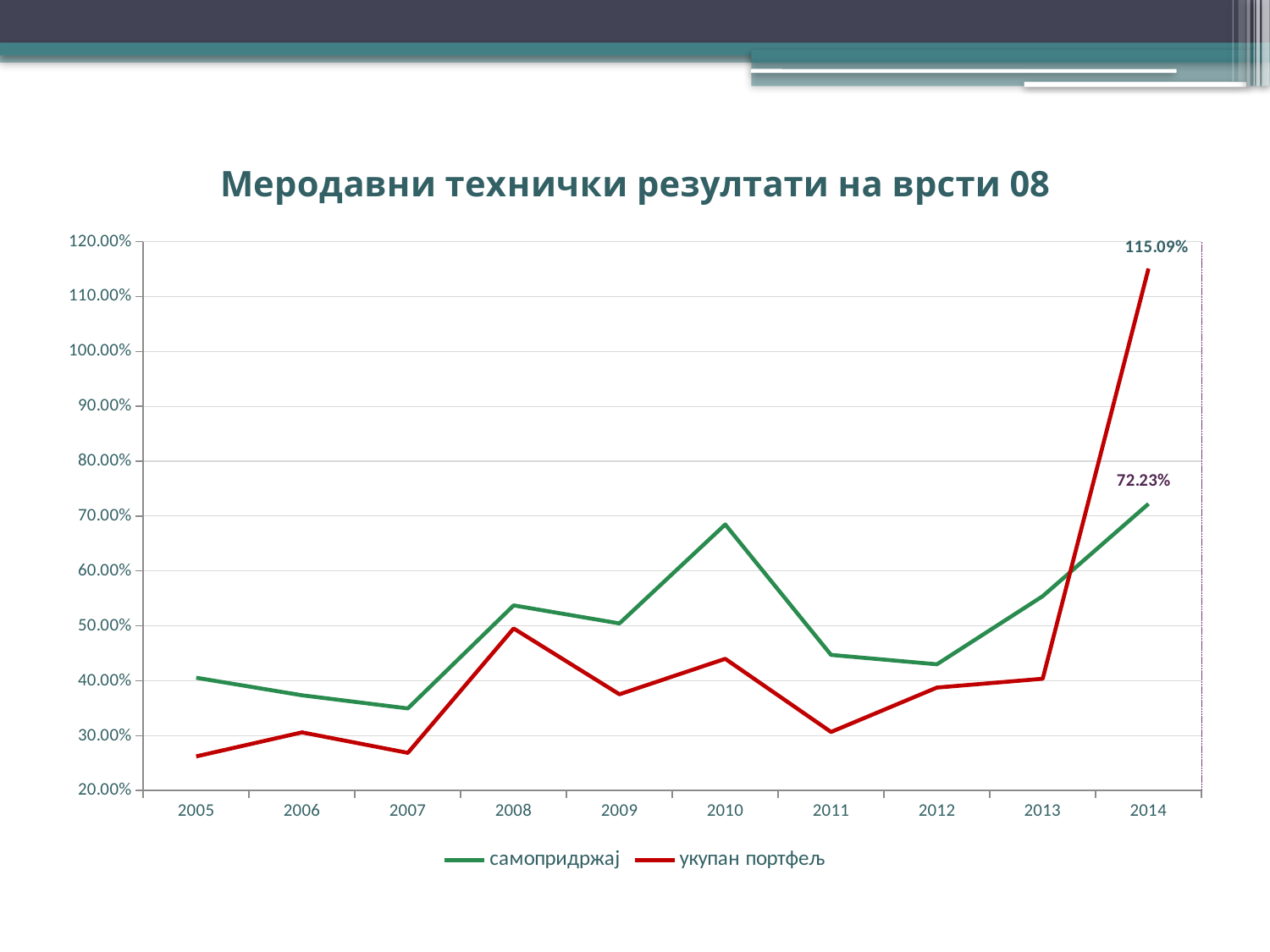
What is the value for укупан портфељ in 2014? 115.09% What kind of chart is shown on the slide? line chart Is the value for укупан портфељ in 2005 greater or less than 30%? less What is the difference between укупан портфељ and самопридржај in 2014? 42.86% Is the value for укупан портфељ in 2011 greater or less than 40%? less What is the value for самопридржај in 2014? 72.23% In 2014, which series has the larger value, самопридржај or укупан портфељ? укупан портфељ Is the value for самопридржај in 2010 greater or less than 60%? greater How many series does the legend list? 2 How many years are shown on the x axis? 10 Does the value for укупан портфељ rise or fall from 2013 to 2014? rise In which year does укупан портфељ reach its highest value? 2014